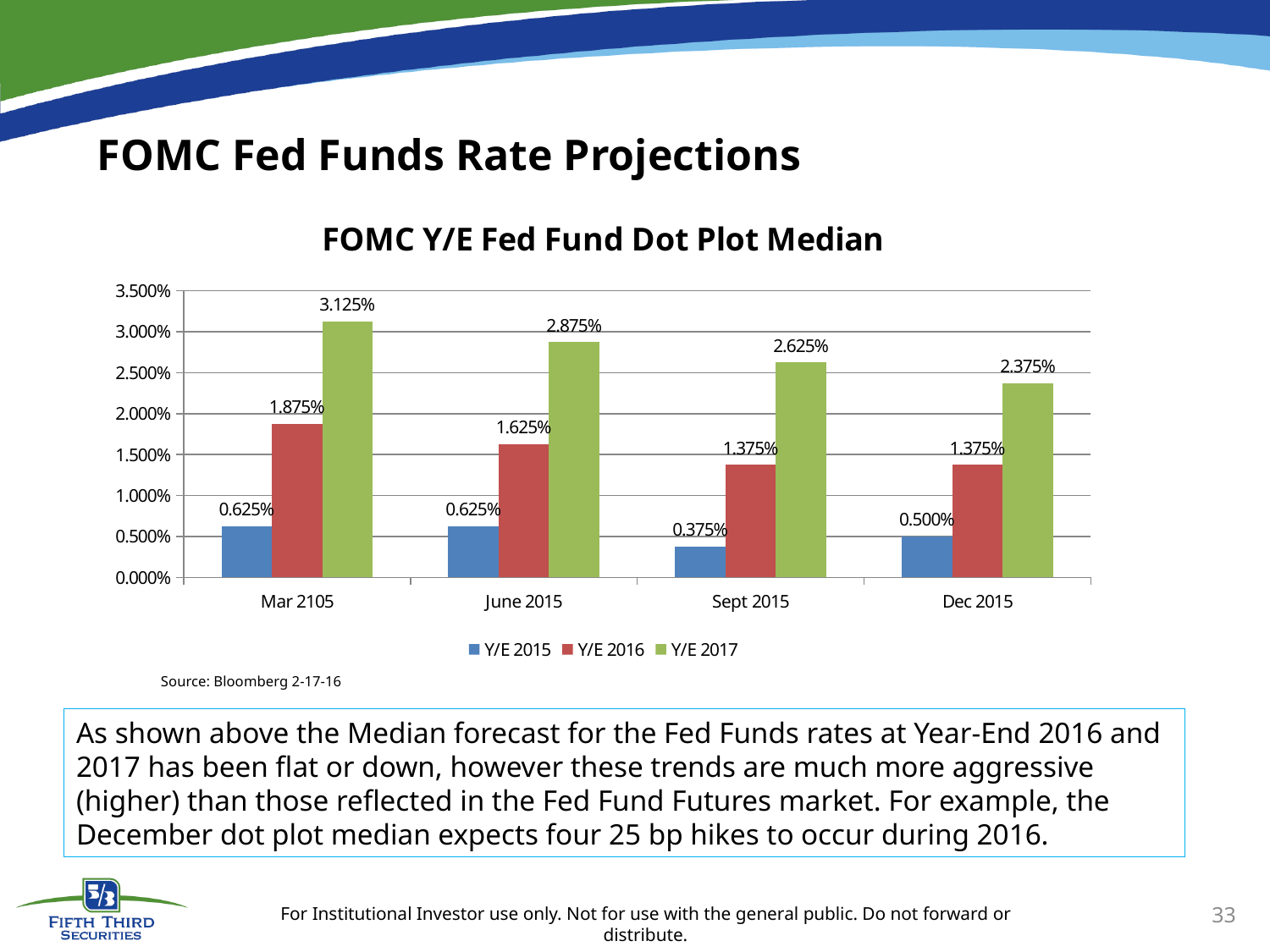
What is the Y/E 2017 value for June 2015? 2.875% Which category has the lowest Y/E 2015 value? Sept 2015 What kind of chart is shown on the slide? Bar chart How many series does the legend list? 3 Which is larger: the Y/E 2016 value for Mar 2105 or the Y/E 2016 value for June 2015? Mar 2105 Do the Y/E 2017 values rise or fall from Mar 2105 to Dec 2015? Fall Which category has the highest Y/E 2017 value? Mar 2105 What is the Y/E 2015 value for Dec 2015? 0.500% What is the Y/E 2016 value for Sept 2015? 1.375% How many categories are shown on the x axis? 4 What is the difference between the Y/E 2017 value for Mar 2105 and the Y/E 2017 value for Dec 2015? 0.750% What is the title of the chart? FOMC Y/E Fed Fund Dot Plot Median